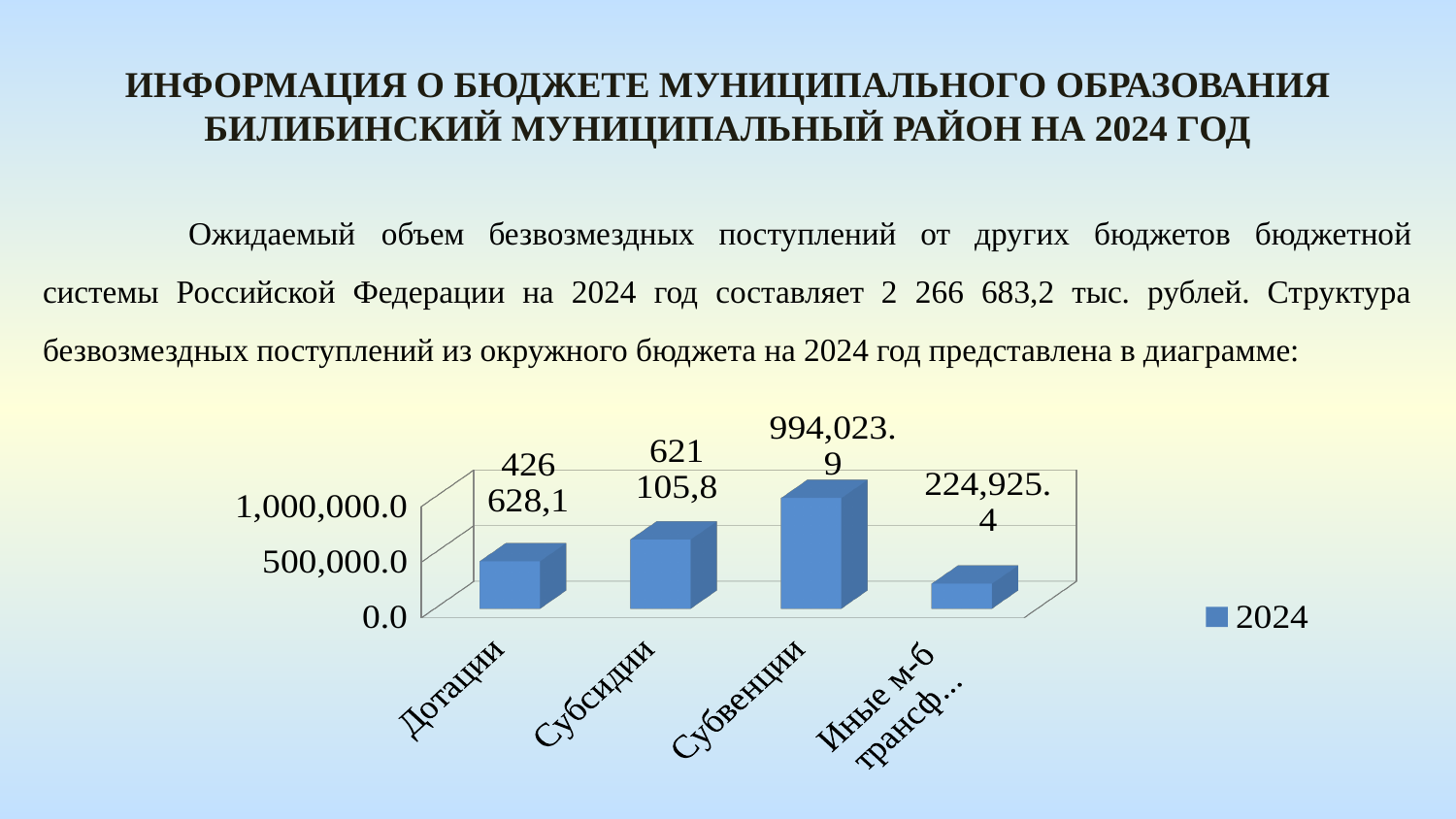
Which category has the highest value? Субвенции Which category has the lowest value? Иные м-б трансф... What is the value shown for Дотации? 426 628,1 What is the value shown for the fourth category, Иные м-б трансф...? 224,925.4 Which is larger, the value for Субсидии or the value for Дотации? Субсидии How many categories are plotted in the chart? 4 What is the value shown for Субсидии? 621 105,8 What is the value shown for Субвенции? 994,023.9 What series name is shown in the chart legend? 2024 Is the value for Субвенции greater or less than 500,000.0? greater How many series does the chart legend list? 1 What type of chart is shown on the slide? bar chart